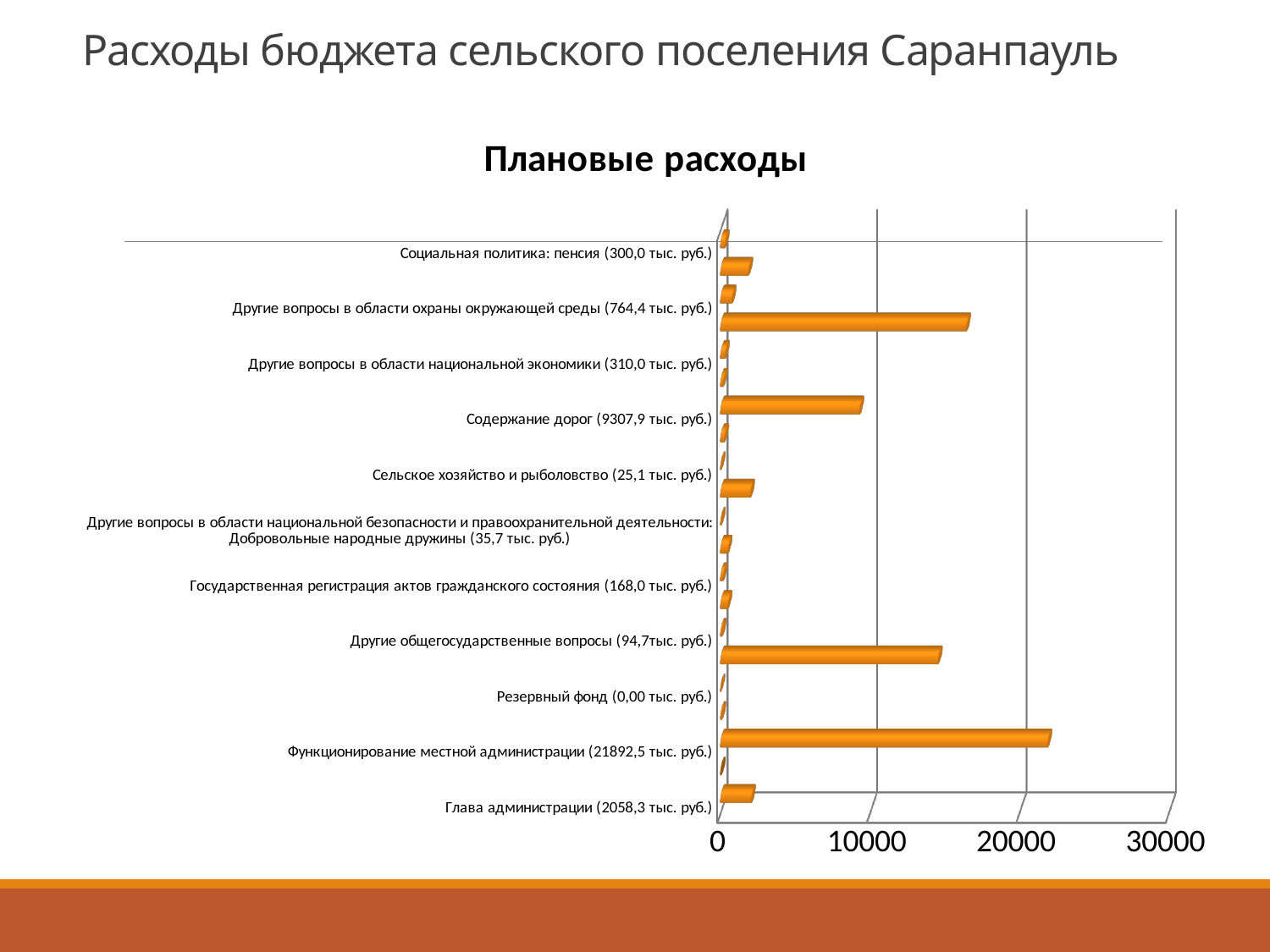
What is the planned expenditure for Резервный фонд? 0,00 тыс. руб. What is the planned expenditure for Глава администрации? 2058,3 тыс. руб. Is the bar for Функционирование местной администрации greater or less than 20000? greater Which is larger, the expenditure for Содержание дорог or for Глава администрации? Содержание дорог What is the planned expenditure for Социальная политика: пенсия? 300,0 тыс. руб. Which category has the longest bar in the chart? Функционирование местной администрации What is the planned expenditure for Содержание дорог? 9307,9 тыс. руб. Is the bar for Содержание дорог greater or less than 10000? less What is the difference between the expenditure for Функционирование местной администрации and Содержание дорог? 12584,6 тыс. руб. What is the planned expenditure for Функционирование местной администрации? 21892,5 тыс. руб. What is the title of the chart? Плановые расходы What kind of chart is shown on the slide? Bar chart